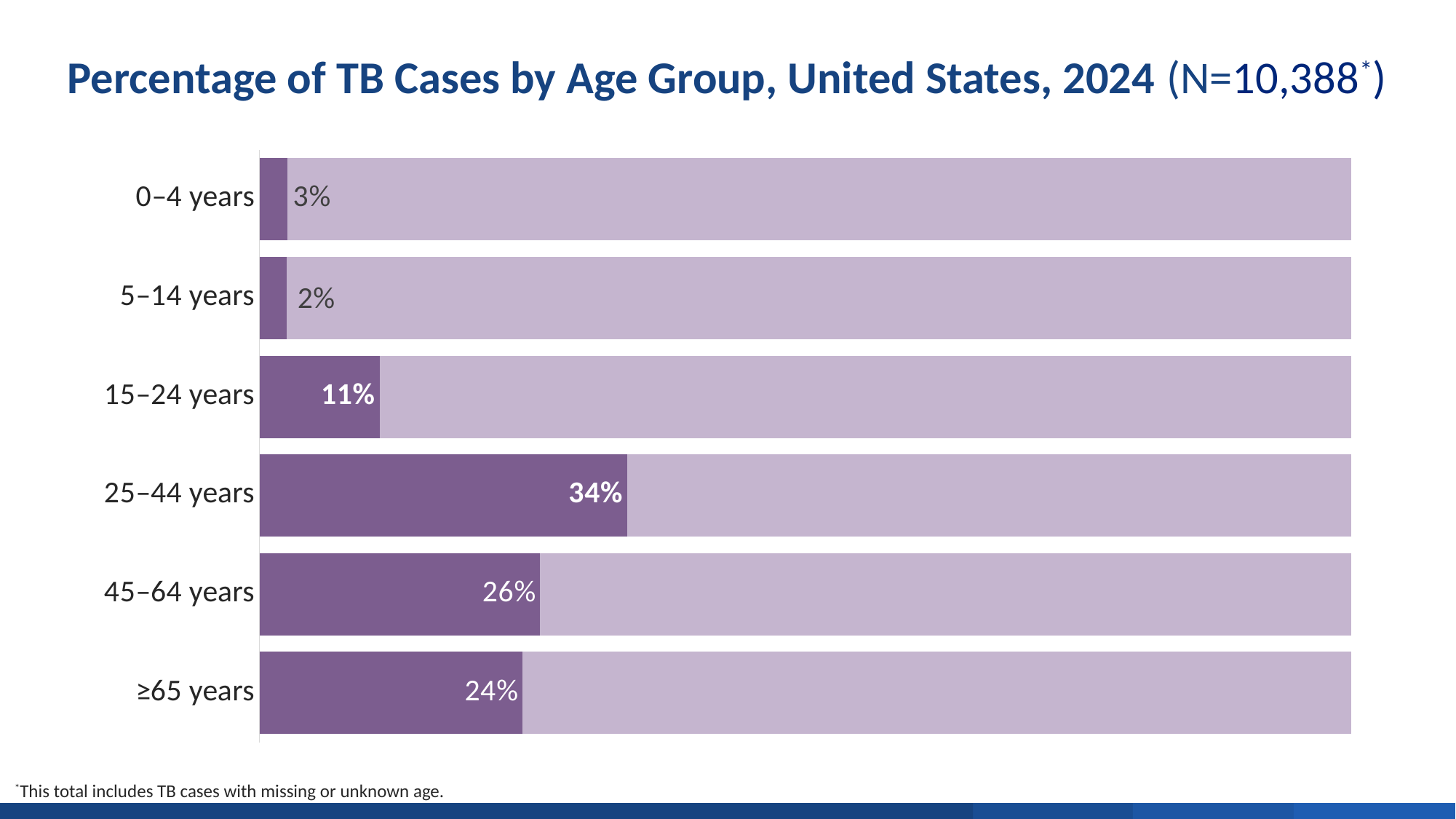
What percentage of TB cases were in the 15–24 years age group? 11% What percentage of TB cases were in the 25–44 years age group? 34% Which age group has the lowest percentage of TB cases? 5–14 years What kind of chart is shown on the slide? Bar chart Which age group has a larger percentage of TB cases, 15–24 years or ≥65 years? ≥65 years Which age group has the highest percentage of TB cases? 25–44 years What is the difference in percentage points between the 25–44 years and 45–64 years age groups? 8 What is the difference in percentage points between the 45–64 years and ≥65 years age groups? 2 What percentage of TB cases were in the 0–4 years age group? 3% What percentage of TB cases were in the ≥65 years age group? 24% How many age groups are shown in the chart? 6 What is the total number of TB cases (N) given in the chart title? 10,388